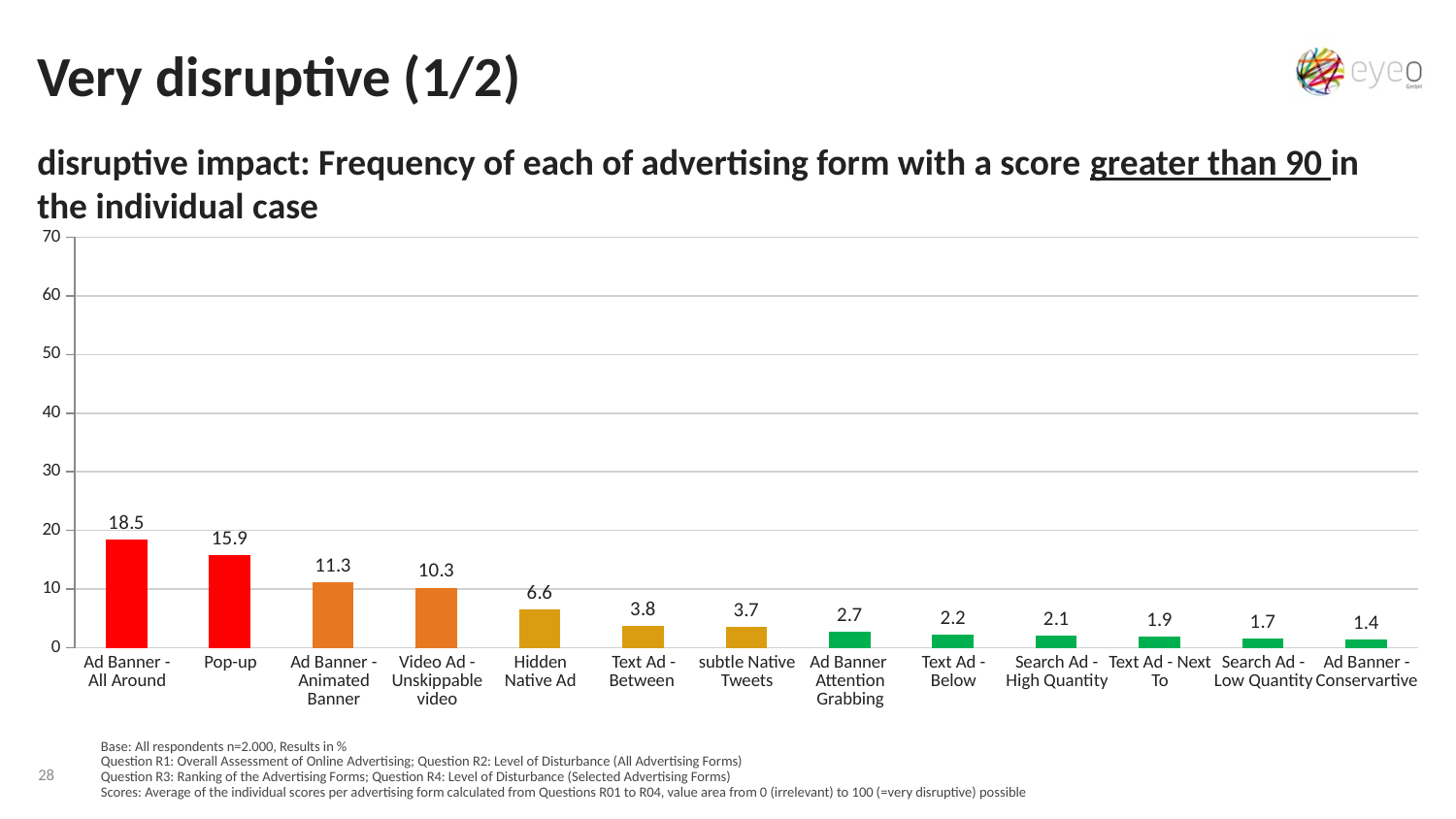
What is the difference between the values for Ad Banner - Animated Banner and Video Ad - Unskippable video? 1.0 What is the difference between the values for Ad Banner - All Around and Pop-up? 2.6 What is the value for Hidden Native Ad? 6.6 Which category has the lowest value? Ad Banner - Conservartive Do the values rise or fall from left to right along the x axis? fall What is the value for Search Ad - High Quantity? 2.1 What is the value for Pop-up? 15.9 Is the value for Ad Banner - Animated Banner greater or less than 10? greater Which is larger, the value for Text Ad - Between or the value for Ad Banner Attention Grabbing? Text Ad - Between What kind of chart is shown on the slide? bar chart How many categories are shown on the x axis? 13 Which category has the highest value? Ad Banner - All Around